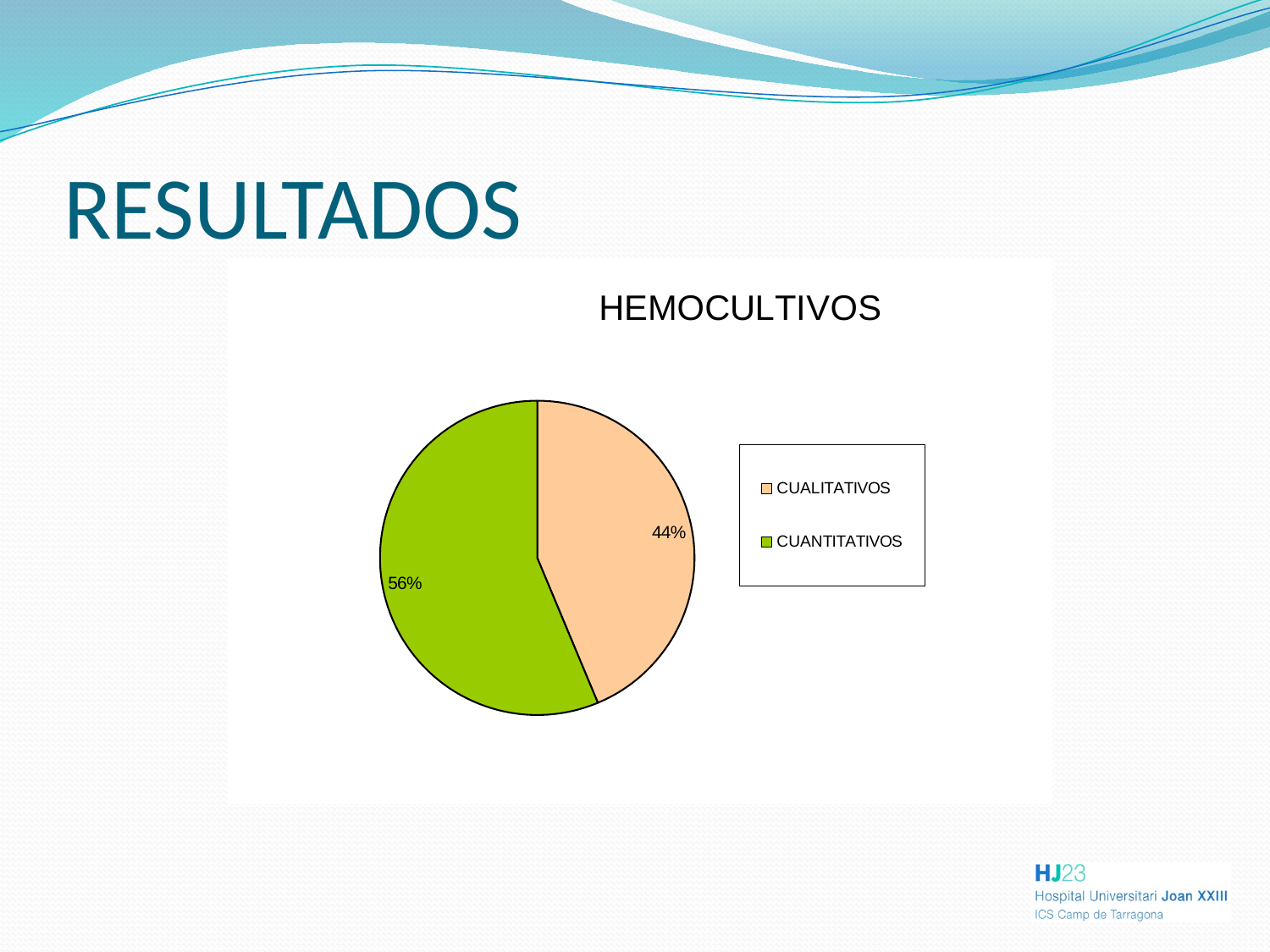
What percentage of the pie is CUALITATIVOS? 44% Which is larger, the CUALITATIVOS slice or the CUANTITATIVOS slice? CUANTITATIVOS Which category has the largest share of the pie? CUANTITATIVOS What is the difference in percentage points between CUANTITATIVOS and CUALITATIVOS? 12 What colour is the CUANTITATIVOS slice? green Which category has the smallest share of the pie? CUALITATIVOS What percentage of the pie is CUANTITATIVOS? 56% How many entries does the legend list? 2 What share of the pie does the CUALITATIVOS slice represent? 44% What type of chart is shown on the slide? pie chart How many slices does the pie chart have? 2 What is the title of the chart? HEMOCULTIVOS